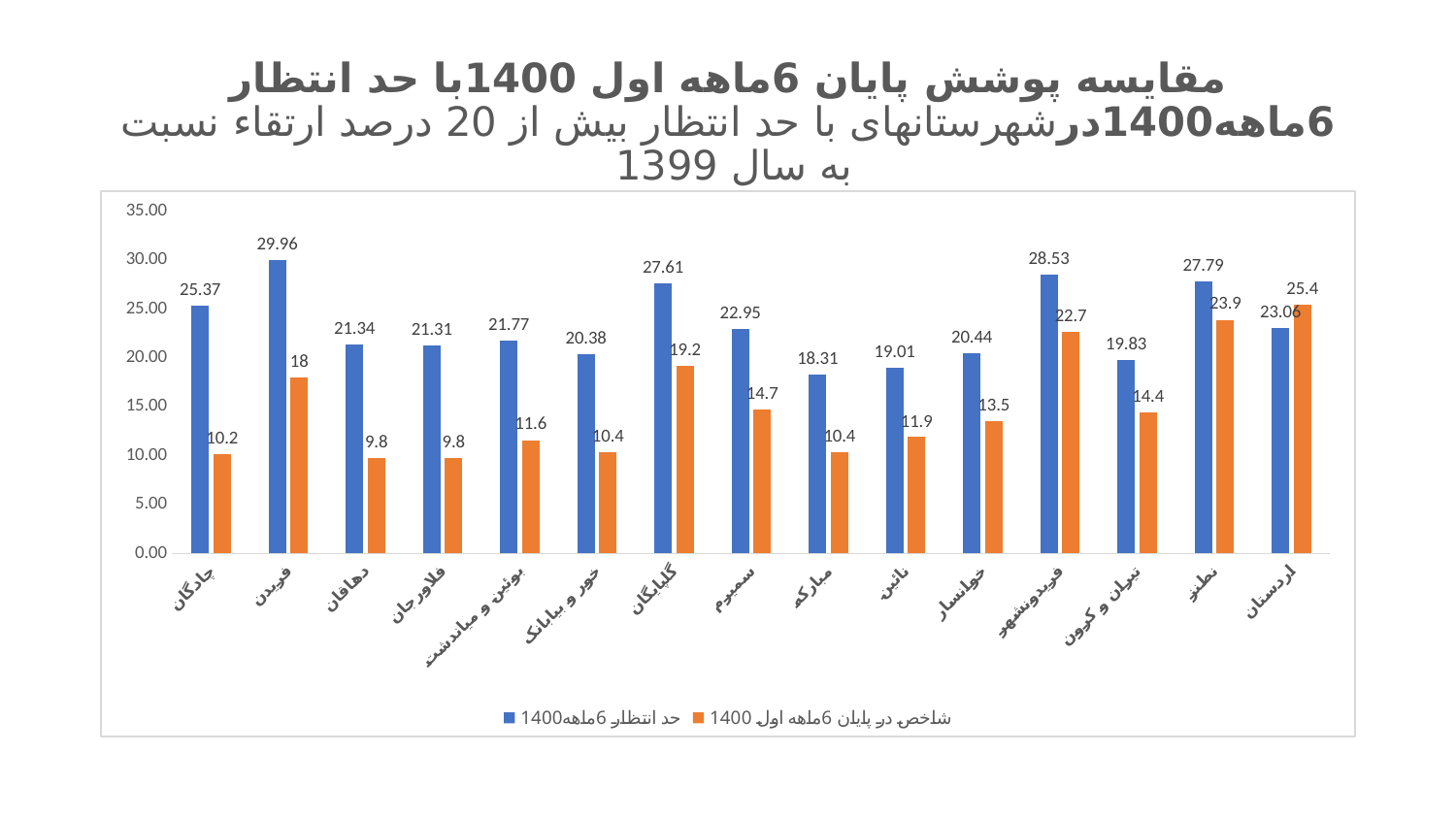
What is the value of شاخص در پایان 6ماهه اول 1400 for مبارکه? 10.4 What is the value of حد انتظار 6ماهه1400 for گلپایگان? 27.61 Which city has the lowest value for شاخص در پایان 6ماهه اول 1400? دهاقان and فلاورجان (both 9.8) What type of chart is shown on the slide? bar chart What is the difference between the شاخص در پایان 6ماهه اول 1400 value and the حد انتظار 6ماهه1400 value for چادگان? 15.17 How many categories (cities) are shown on the x axis? 15 How many series does the legend list? 2 Which city has the highest value for حد انتظار 6ماهه1400? فریدن For اردستان, which is larger: شاخص در پایان 6ماهه اول 1400 or حد انتظار 6ماهه1400? شاخص در پایان 6ماهه اول 1400 Which city has the highest value for شاخص در پایان 6ماهه اول 1400? اردستان Which colour represents the حد انتظار 6ماهه1400 series? blue What is the value of شاخص در پایان 6ماهه اول 1400 for فریدن? 18